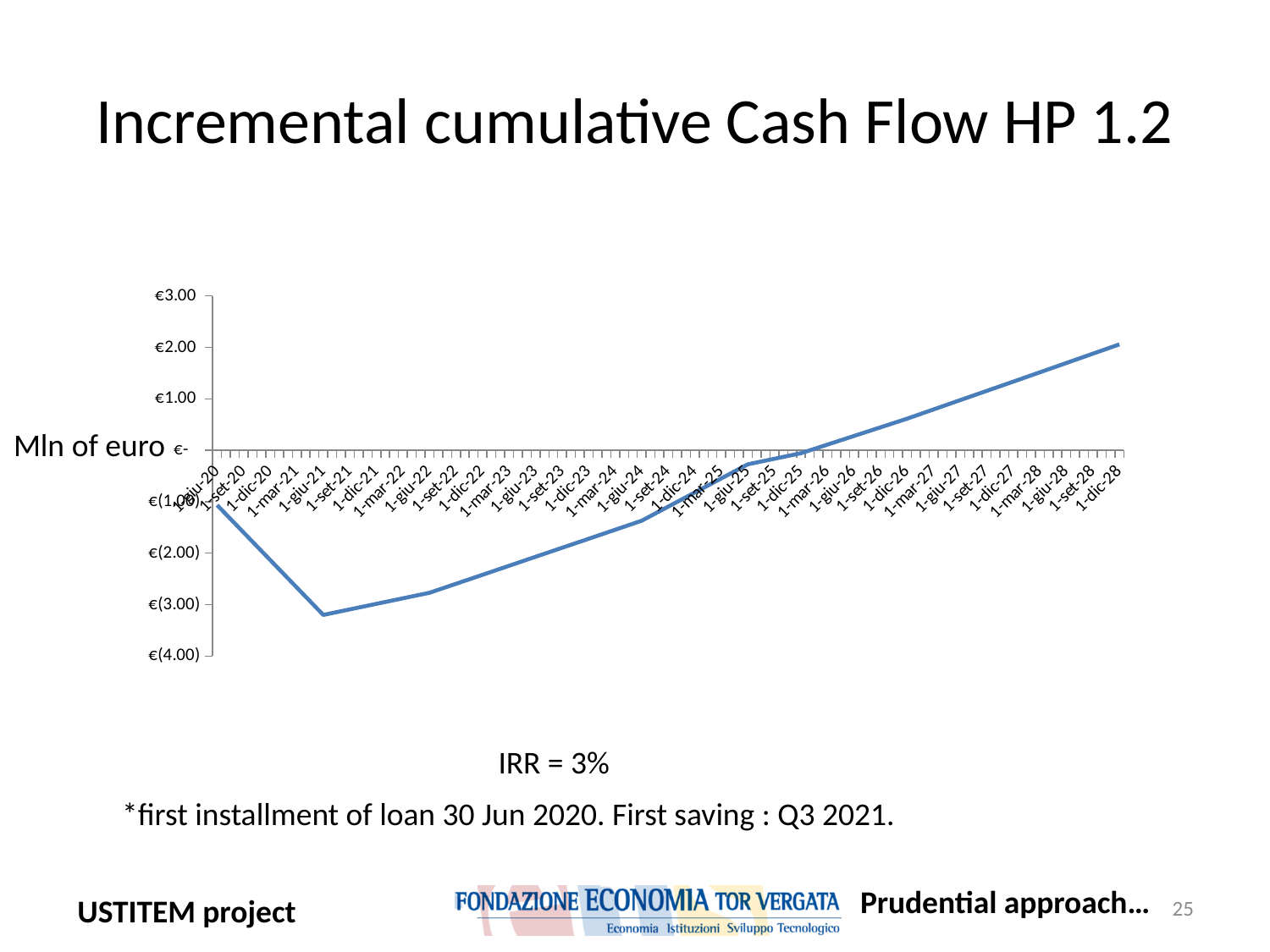
Is the value at 1-dic-22 greater or less than €(2.00)? less At which date does the line reach its lowest value? 1-giu-21 Which is larger, the value at 1-giu-21 or the value at 1-dic-28? 1-dic-28 Is the value at 1-giu-24 greater or less than €(1.00)? less What kind of chart is shown on the slide? line chart Is the value at 1-giu-21 greater or less than €(2.00)? less At which date does the line reach its highest value? 1-dic-28 After 1-giu-21, do the values rise or fall along the x axis? rise What unit is indicated for the vertical axis of the chart? Mln of euro What is the title of the chart on the slide? Incremental cumulative Cash Flow HP 1.2